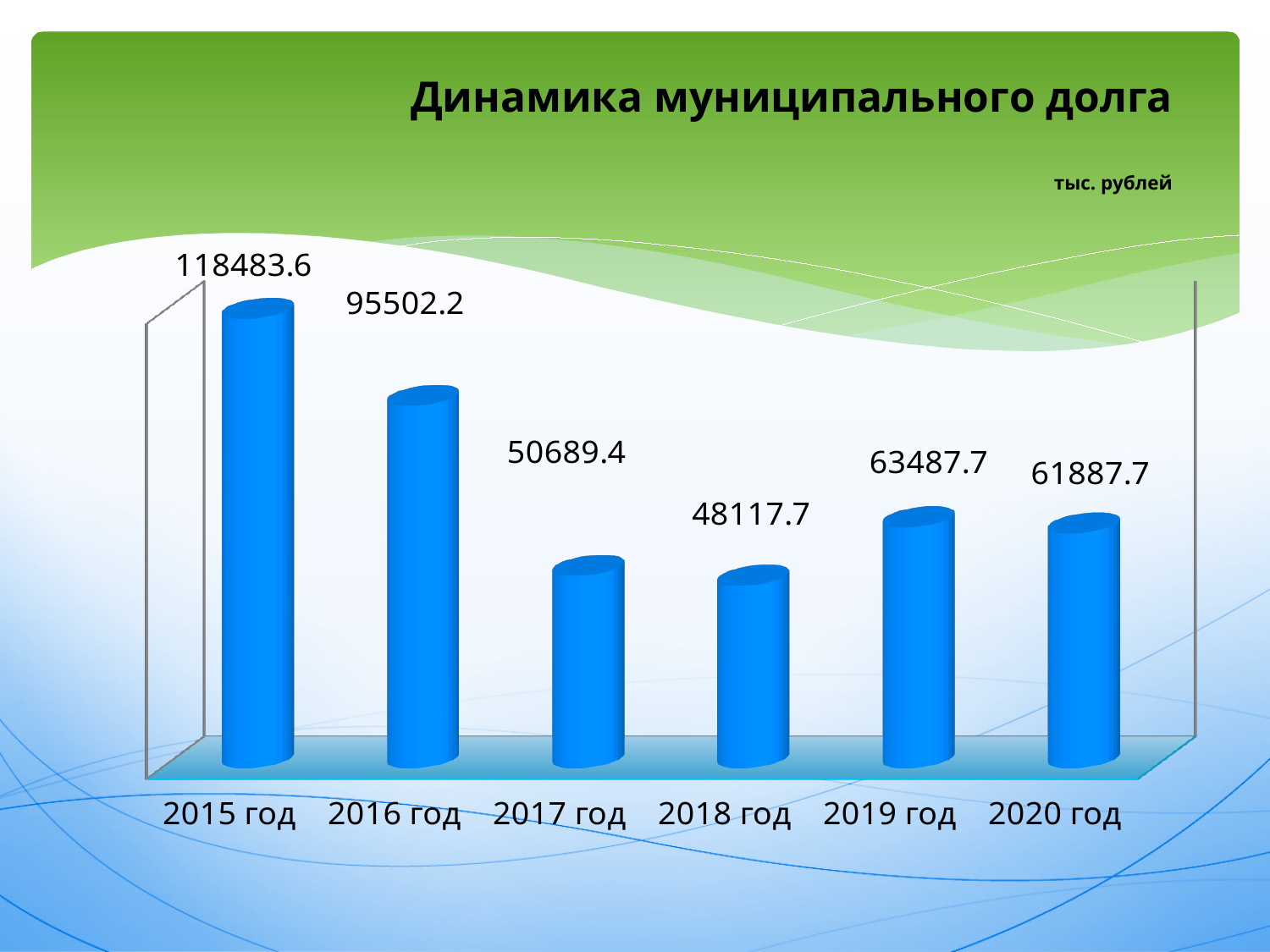
Which is larger, the value for 2017 год or the value for 2018 год? 2017 год What is the municipal debt value for 2015 год? 118483.6 What unit is indicated for the chart values? тыс. рублей What is the difference between the values for 2015 год and 2016 год? 22981.4 How many years are shown on the chart? 6 What is the value shown for 2018 год? 48117.7 Which year has the highest municipal debt? 2015 год What is the difference between the values for 2019 год and 2020 год? 1600 Which year has the lowest municipal debt? 2018 год What kind of chart is shown on the slide? bar chart What is the value shown for 2020 год? 61887.7 From 2015 год to 2018 год, do the values rise or fall? fall